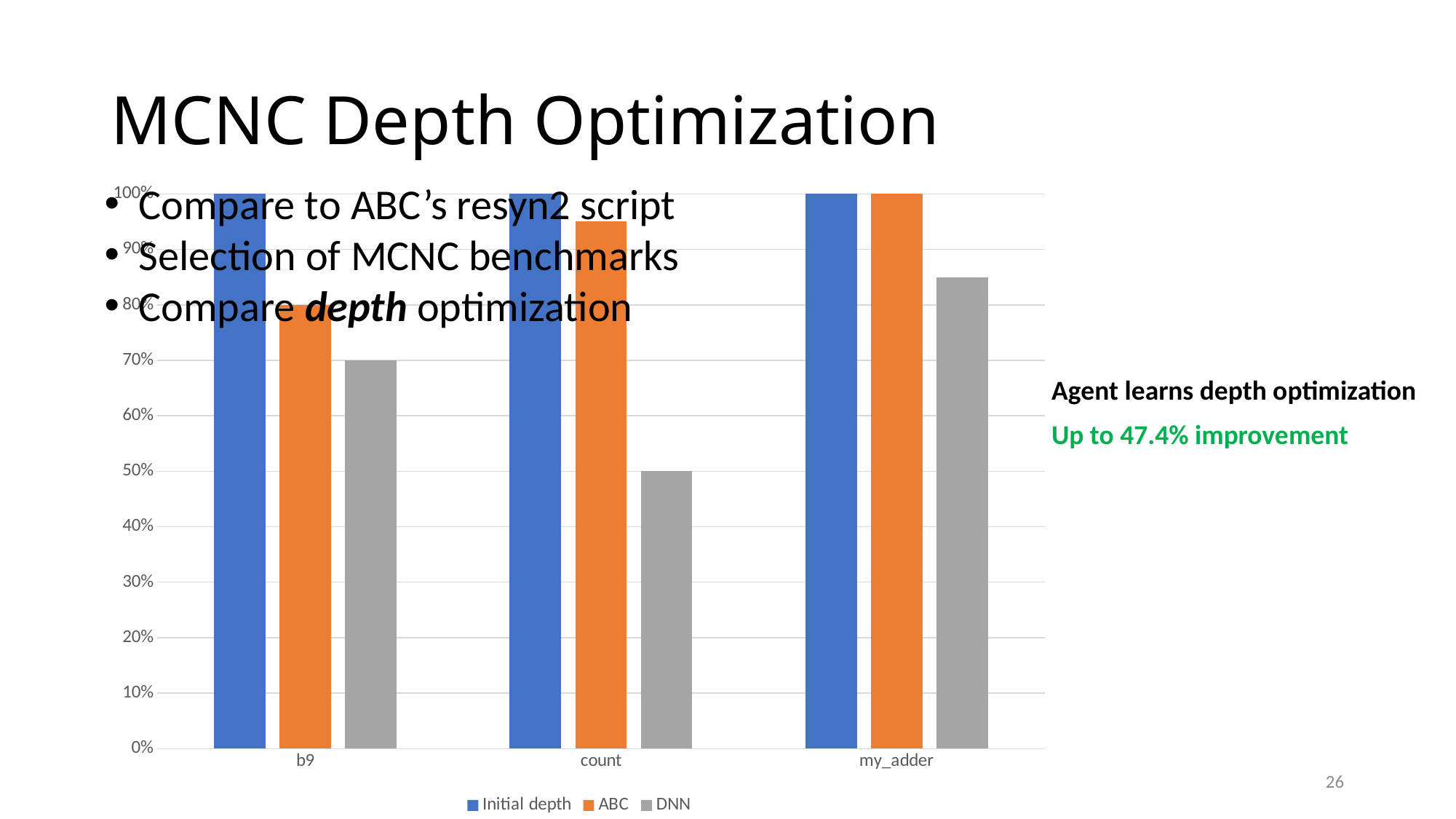
Is the value of the ABC series for count greater or less than 90%? greater What kind of chart is shown on the slide? bar chart Which category has the lowest DNN value? count For b9, which is larger, the ABC value or the DNN value? ABC How many categories are shown on the x axis? 3 What is the value of the DNN series for count? 50% Which series is shown in gray in the legend? DNN Is the value of the DNN series for my_adder greater or less than 80%? greater What is the value of the DNN series for b9? 70% How many series does the legend list? 3 Which category has the highest DNN value? my_adder What is the value of the Initial depth series for b9? 100%